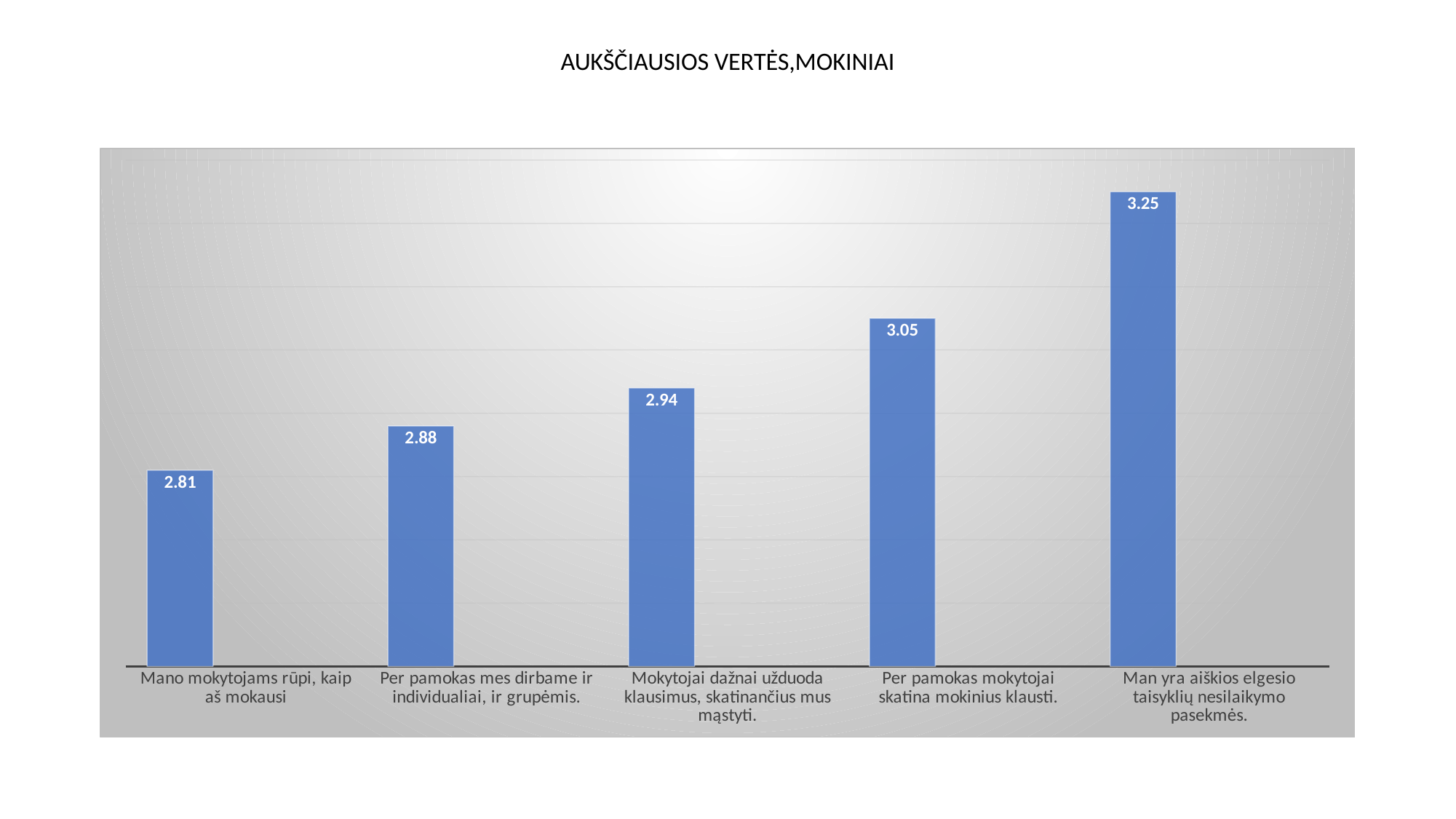
What is the value for "Per pamokas mokytojai skatina mokinius klausti."? 3.05 What is the difference between the values for "Man yra aiškios elgesio taisyklių nesilaikymo pasekmės." and "Mano mokytojams rūpi, kaip aš mokausi"? 0.44 What is the value for "Mokytojai dažnai užduoda klausimus, skatinančius mus mąstyti."? 2.94 How many categories are shown in the chart? 5 Which category has the highest value? Man yra aiškios elgesio taisyklių nesilaikymo pasekmės. Which is larger: the value for "Per pamokas mokytojai skatina mokinius klausti." or for "Mokytojai dažnai užduoda klausimus, skatinančius mus mąstyti."? Per pamokas mokytojai skatina mokinius klausti. Do the values rise or fall from left to right along the x axis? Rise What is the value for "Per pamokas mes dirbame ir individualiai, ir grupėmis."? 2.88 What is the value for "Man yra aiškios elgesio taisyklių nesilaikymo pasekmės."? 3.25 Which category has the lowest value? Mano mokytojams rūpi, kaip aš mokausi What kind of chart is shown on the slide? Bar chart What is the value for "Mano mokytojams rūpi, kaip aš mokausi"? 2.81